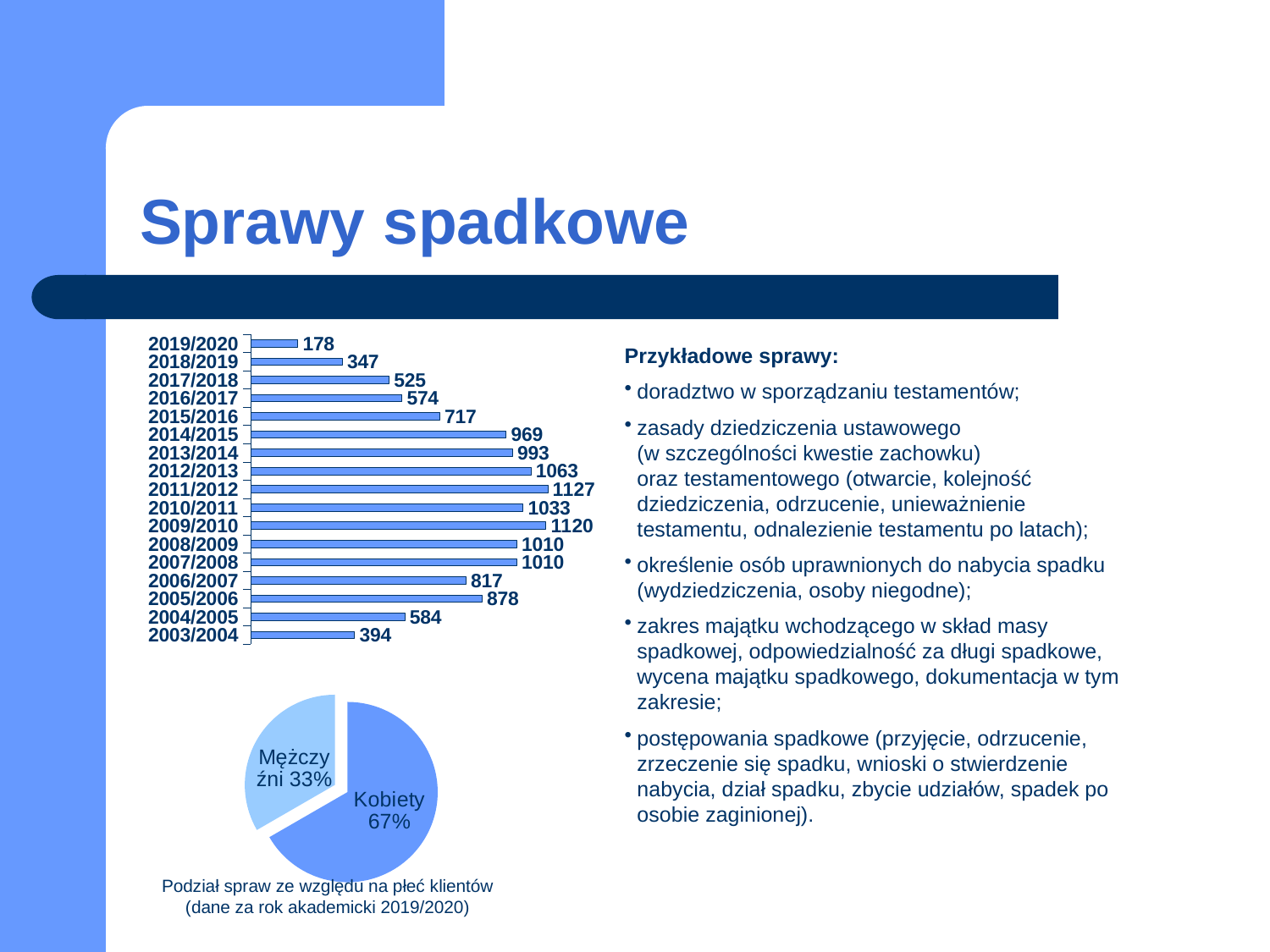
In the bar chart, what is the value for 2003/2004? 394 In the bar chart, which academic year has the lowest value? 2019/2020 In the pie chart, what share of cases is for Kobiety? 67% What kind of chart is the chart at the bottom left of the slide? pie chart In the bar chart, which is larger, the value for 2005/2006 or the value for 2006/2007? 2005/2006 In the bar chart, what is the value for 2019/2020? 178 In the bar chart, which academic year has the highest value? 2011/2012 In the pie chart, what share of cases is for Mężczyźni? 33% What kind of chart is the chart at the top left of the slide? bar chart In the bar chart, what is the difference between the values for 2009/2010 and 2008/2009? 110 In the bar chart, what is the value for 2011/2012? 1127 How many academic years are shown in the bar chart? 17